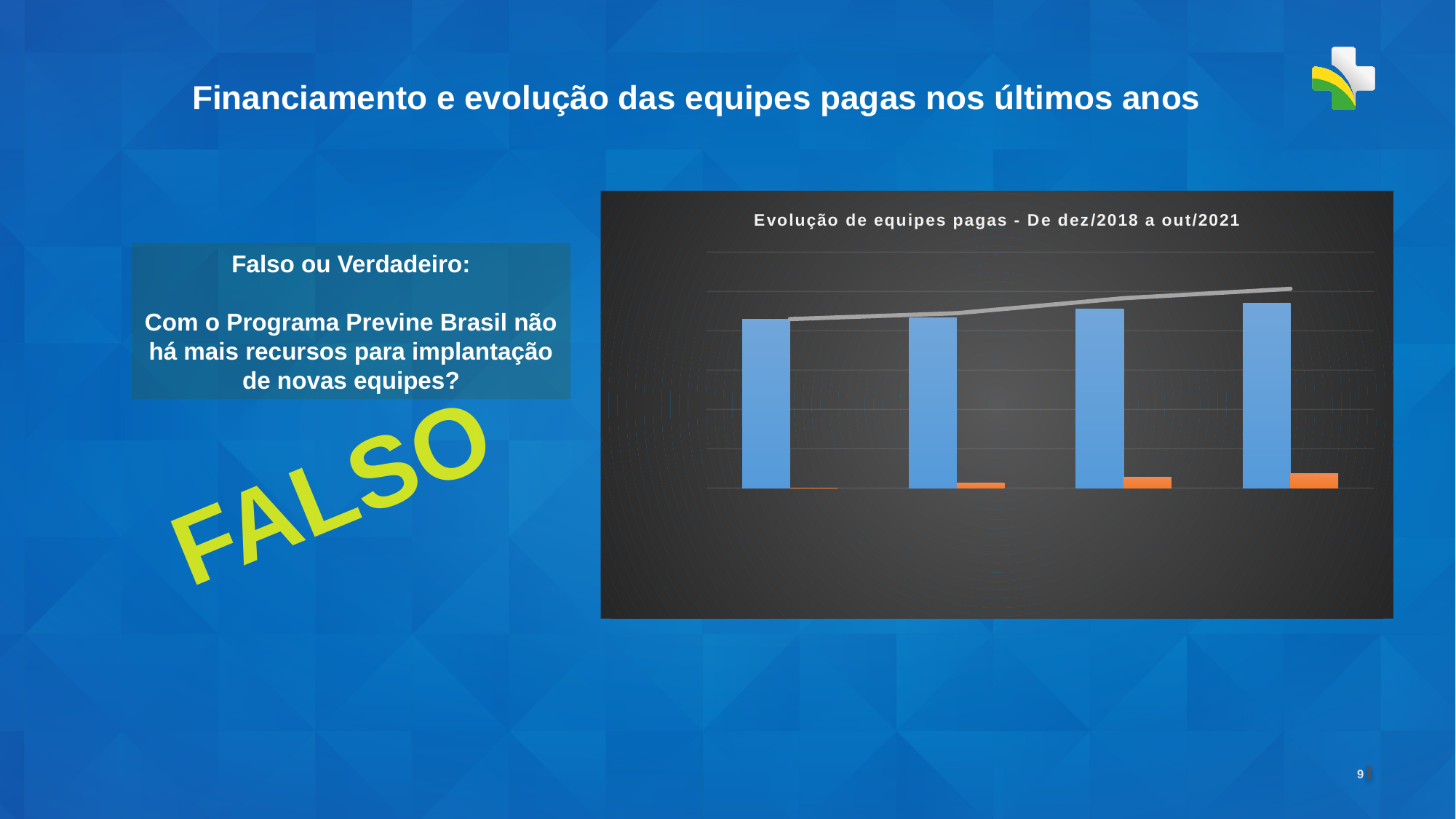
Which group of bars, counting from the left, has the shortest blue bar? the first (leftmost) Do the blue bars rise or fall from left to right across the chart? rise What kind of chart is shown on the slide? combination bar and line chart In the leftmost group of bars, which is taller: the blue bar or the orange bar? the blue bar Which colour are the taller bars in each group of the chart? blue Do the orange bars rise or fall from left to right across the chart? rise Does the grey line in the chart rise or fall from left to right? rise Which group of bars, counting from the left, has the shortest orange bar? the first (leftmost) What is the title of the chart on the slide? Evolução de equipes pagas - De dez/2018 a out/2021 Which group of bars, counting from the left, has the tallest blue bar? the fourth (rightmost) How many groups of bars are plotted in the chart? 4